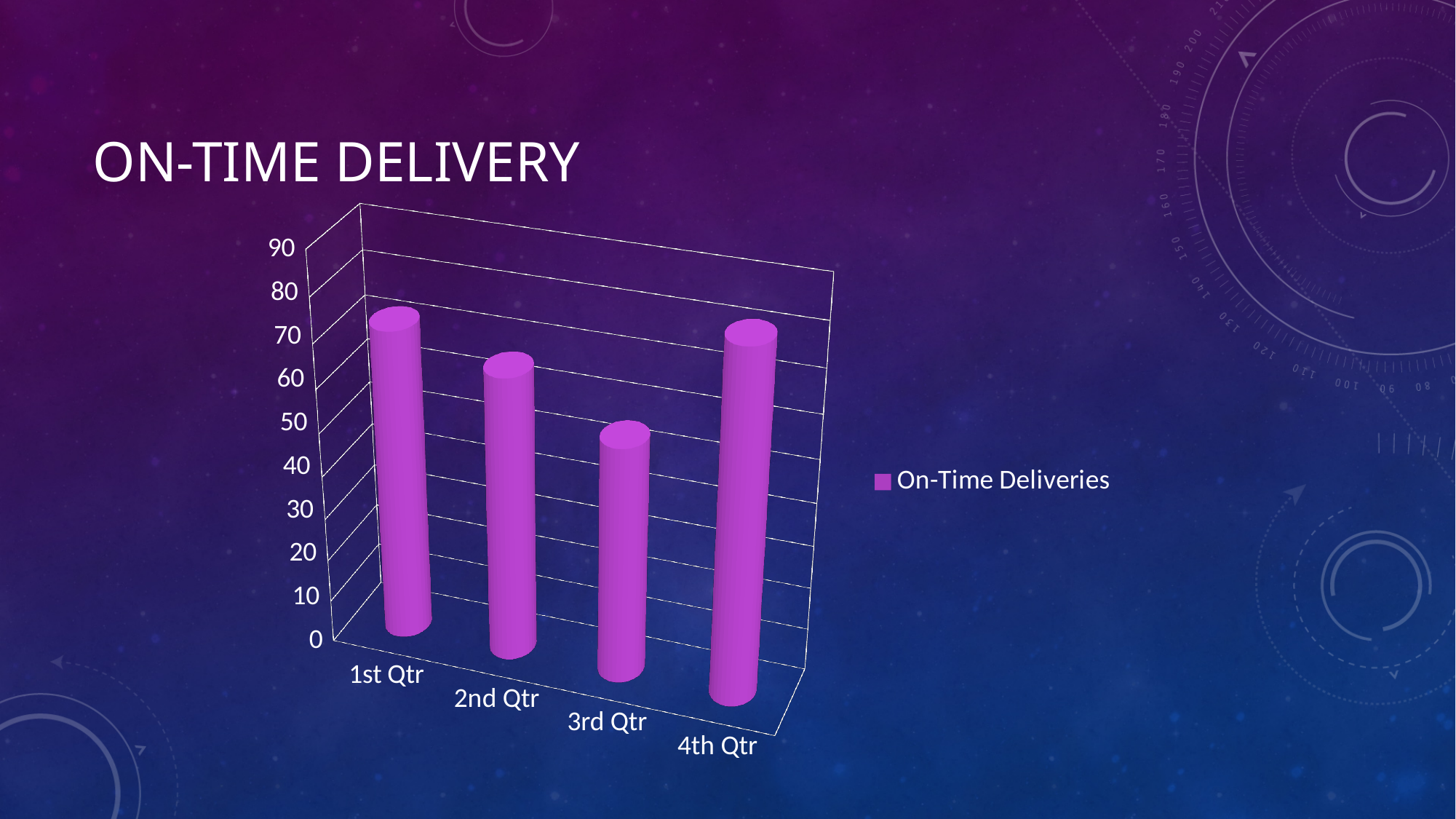
Is the value for 3rd Qtr greater or less than 70? less Which is larger, the value for 1st Qtr or the value for 2nd Qtr? 1st Qtr What is the title of the slide containing the chart? On-Time Delivery Which quarter has the highest value for On-Time Deliveries? 4th Qtr What kind of chart is shown on the slide? Bar chart How many quarters are plotted on the chart? 4 Which quarter has the lowest value for On-Time Deliveries? 3rd Qtr What is the name of the series shown in the legend? On-Time Deliveries Which is larger, the value for 3rd Qtr or the value for 4th Qtr? 4th Qtr How many series does the legend list? 1 Is the value for 1st Qtr greater or less than 60? greater Do the values fall or rise from 1st Qtr to 3rd Qtr? fall